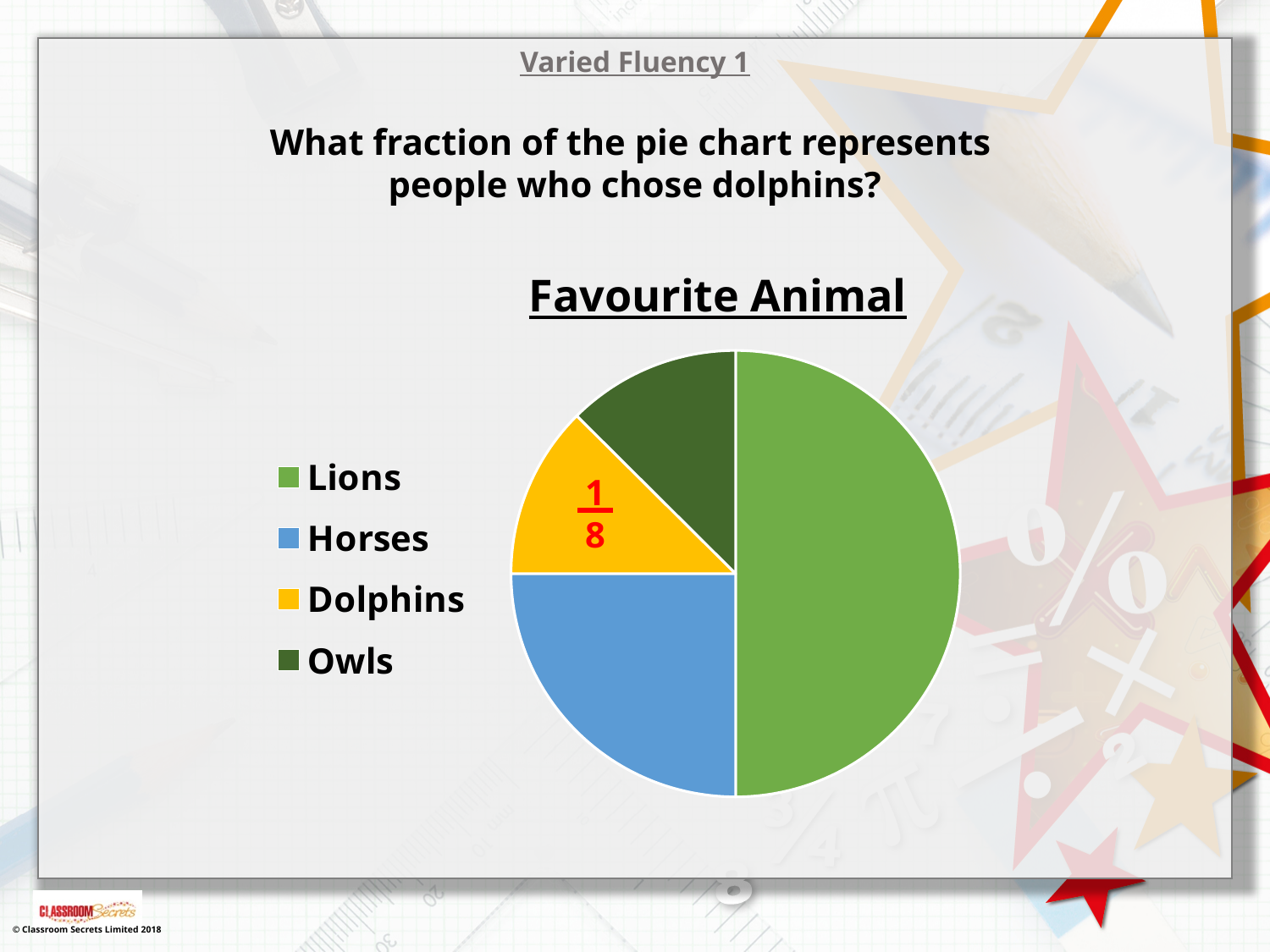
How many categories does the Favourite Animal pie chart show? 4 Which slice is larger in the Favourite Animal pie chart, Lions or Horses? Lions Which category in the Favourite Animal pie chart is shown in yellow? Dolphins Which slice is larger in the Favourite Animal pie chart, Horses or Dolphins? Horses What kind of chart is shown on the slide? pie chart What fraction of the Favourite Animal pie chart is labelled for Dolphins? 1/8 Which categories are listed in the legend of the Favourite Animal pie chart? Lions, Horses, Dolphins, Owls What is the title of the pie chart? Favourite Animal Which animal has the largest slice in the Favourite Animal pie chart? Lions Which slice is larger in the Favourite Animal pie chart, Lions or Owls? Lions